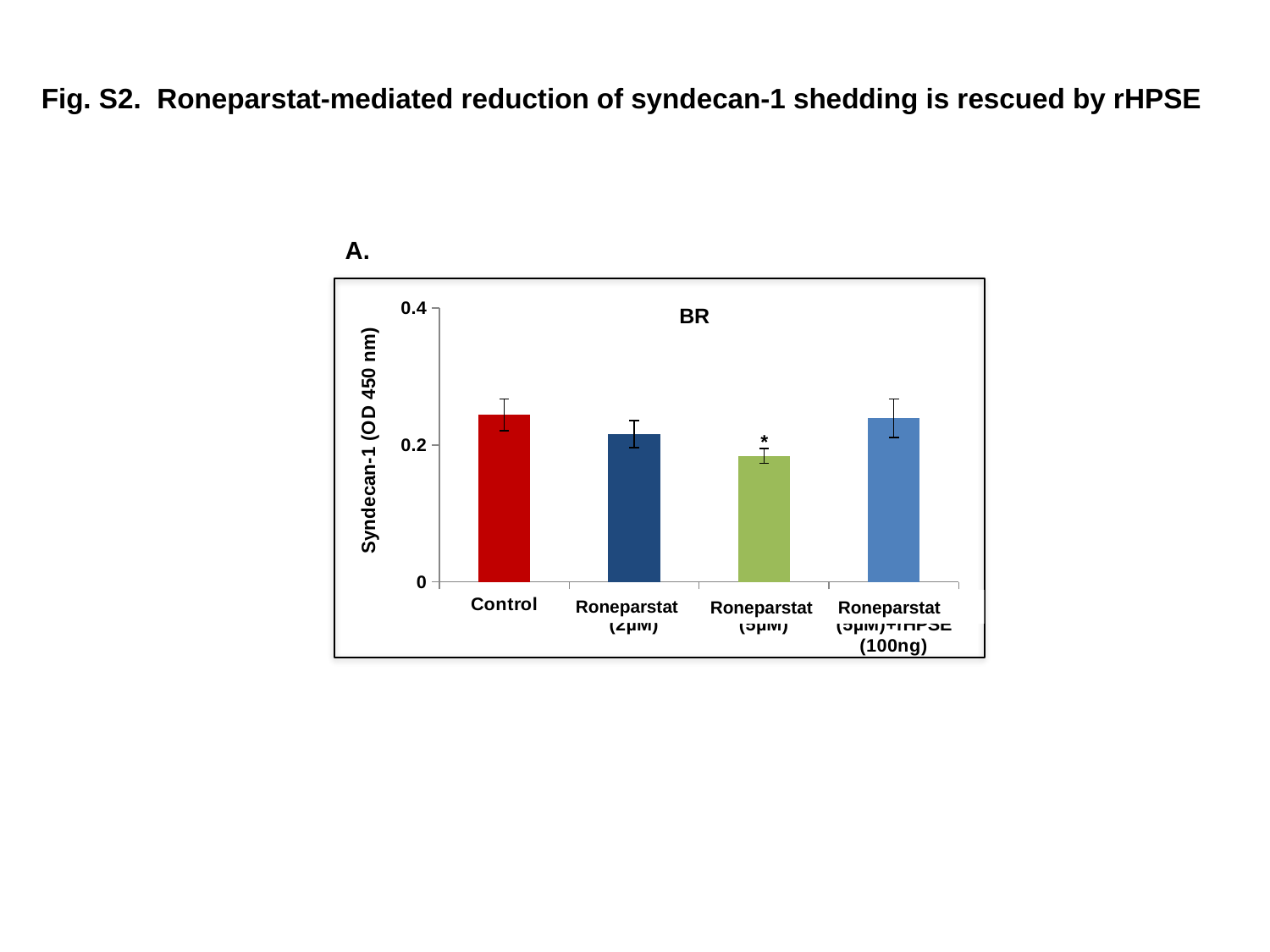
Which is larger, the value for Control or the value for Roneparstat (5µM)? Control What kind of chart is shown on the slide? bar chart Is the value for Control greater or less than 0.2? greater Which category has the lowest Syndecan-1 value? Roneparstat (5µM) Is the value for Control greater or less than 0.4? less Which is larger, the value for Roneparstat (2µM) or the value for Roneparstat (5µM)? Roneparstat (2µM) How many bars (categories) are plotted in the chart? 4 What is the title shown inside the chart? BR Is the value for Roneparstat (5µM)+rHPSE (100ng) greater or less than 0.2? greater What is the label of the y-axis? Syndecan-1 (OD 450 nm)